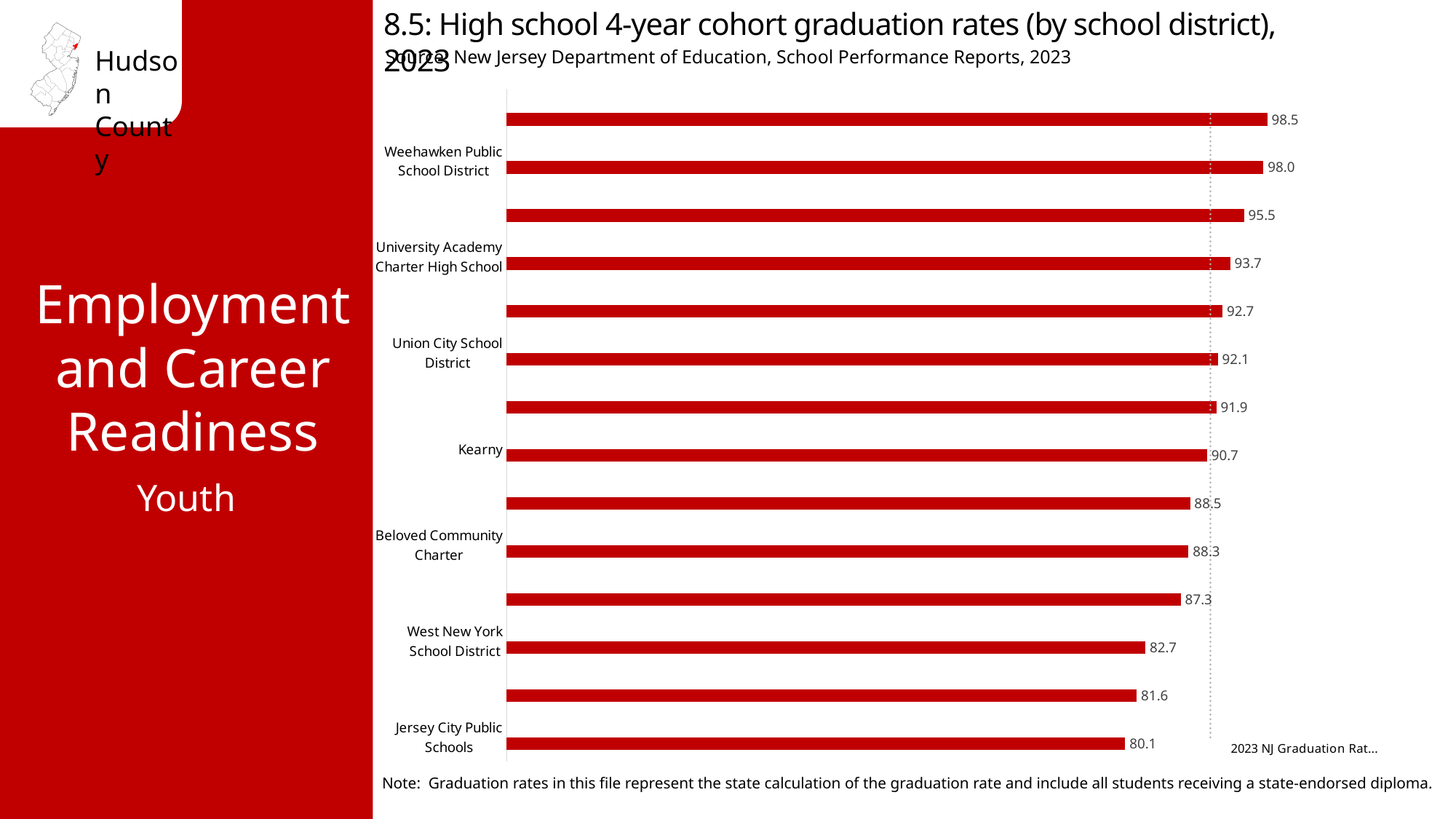
What is the graduation rate for Union City School District? 92.1 What is the highest graduation rate value shown on the chart? 98.5 What is the graduation rate for Jersey City Public Schools? 80.1 Which has a higher graduation rate, Kearny or Beloved Community Charter? Kearny What is the graduation rate for West New York School District? 82.7 What is the source cited for the chart data? New Jersey Department of Education, School Performance Reports, 2023 What type of chart is shown on the slide? bar chart What is the graduation rate for Weehawken Public School District? 98.0 Which labeled school district has the lowest graduation rate? Jersey City Public Schools What is the difference between the graduation rates of Weehawken Public School District and Jersey City Public Schools? 17.9 How many bars are plotted on the chart? 14 What is the graduation rate for Kearny? 90.7